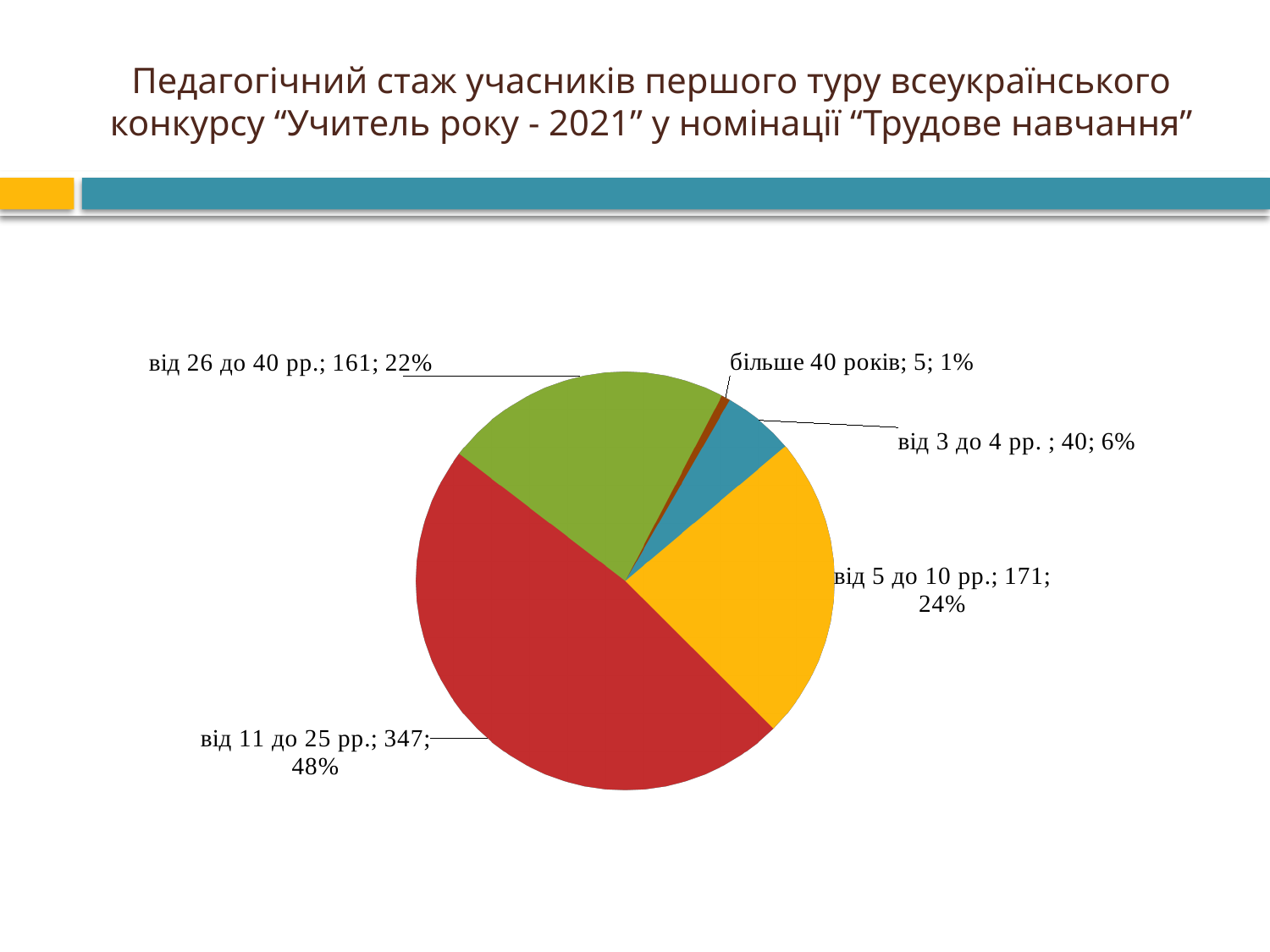
What is the value for "від 3 до 4 рр."? 40 What share of the pie does "більше 40 років" represent? 1% How many slices does the pie chart have? 5 Which is larger, the value for "від 5 до 10 рр." or the value for "від 26 до 40 рр."? від 5 до 10 рр. Which category has the largest slice? від 11 до 25 рр. What is the value for "від 5 до 10 рр."? 171 What is the value for "від 11 до 25 рр."? 347 What kind of chart is shown on the slide? pie chart Which category has the smallest slice? більше 40 років What is the difference between the values for "від 11 до 25 рр." and "від 5 до 10 рр."? 176 What colour is the slice for "від 11 до 25 рр."? red What share of the pie does "від 26 до 40 рр." represent? 22%